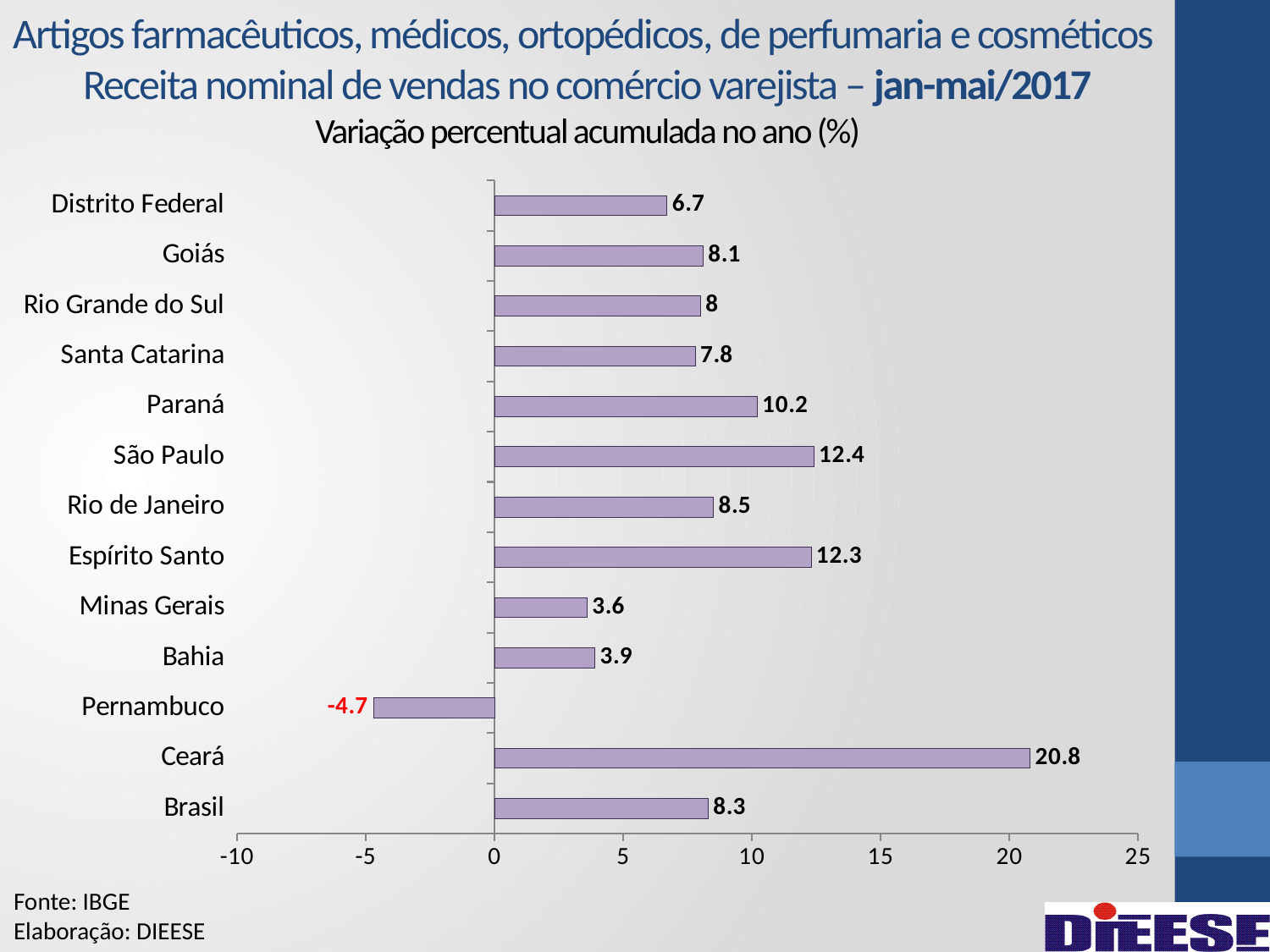
Which category has the highest value? Ceará What is the difference between the values for Ceará and Brasil? 12.5 Is the value for Espírito Santo greater or less than 10? greater What is the value for São Paulo? 12.4 How many categories are shown on the chart? 13 What is the value for Ceará? 20.8 What is the value for Brasil? 8.3 Which category has the lowest value? Pernambuco What is the source cited for the chart data? IBGE Which is larger, the value for Paraná or the value for Rio de Janeiro? Paraná What is the value for Pernambuco? -4.7 What kind of chart is shown on the slide? bar chart